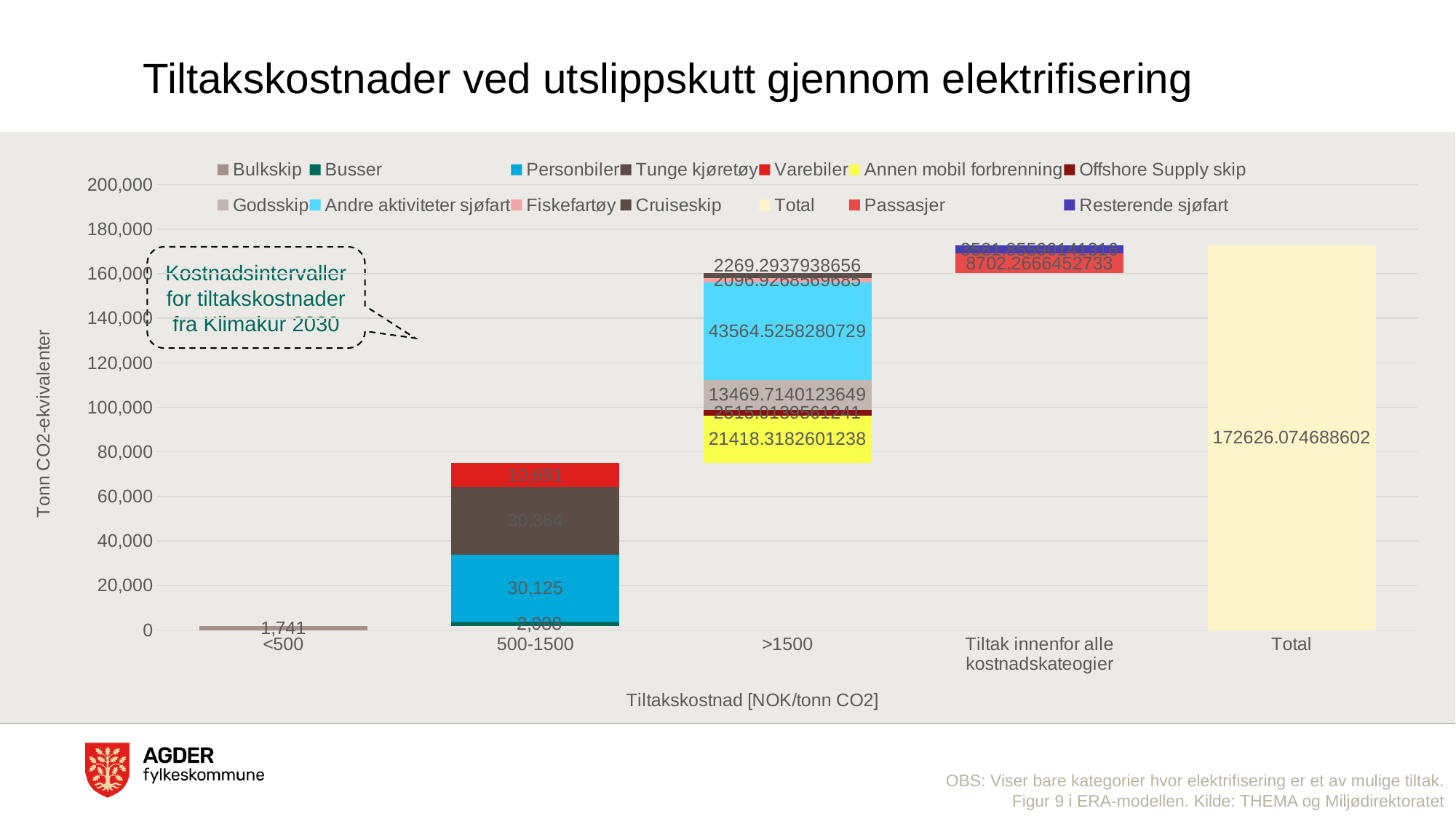
What is the value for Bulkskip in the <500 category? 1,741 How many series does the chart legend list? 14 What kind of chart is shown on the slide? Stacked bar chart What is the value shown for the Total bar? 172626.074688602 What is the value for Personbiler in the 500-1500 category? 30,125 In the 500-1500 category, which is larger: Personbiler or Varebiler? Personbiler What is the difference between Tunge kjøretøy (30,364) and Personbiler (30,125) in the 500-1500 category? 239 What is the value for Tunge kjøretøy in the 500-1500 category? 30,364 How many categories are shown along the x axis of the chart? 5 What is the title of the y axis? Tonn CO2-ekvivalenter What is the value for Andre aktiviteter sjøfart in the >1500 category? 43564.5258280729